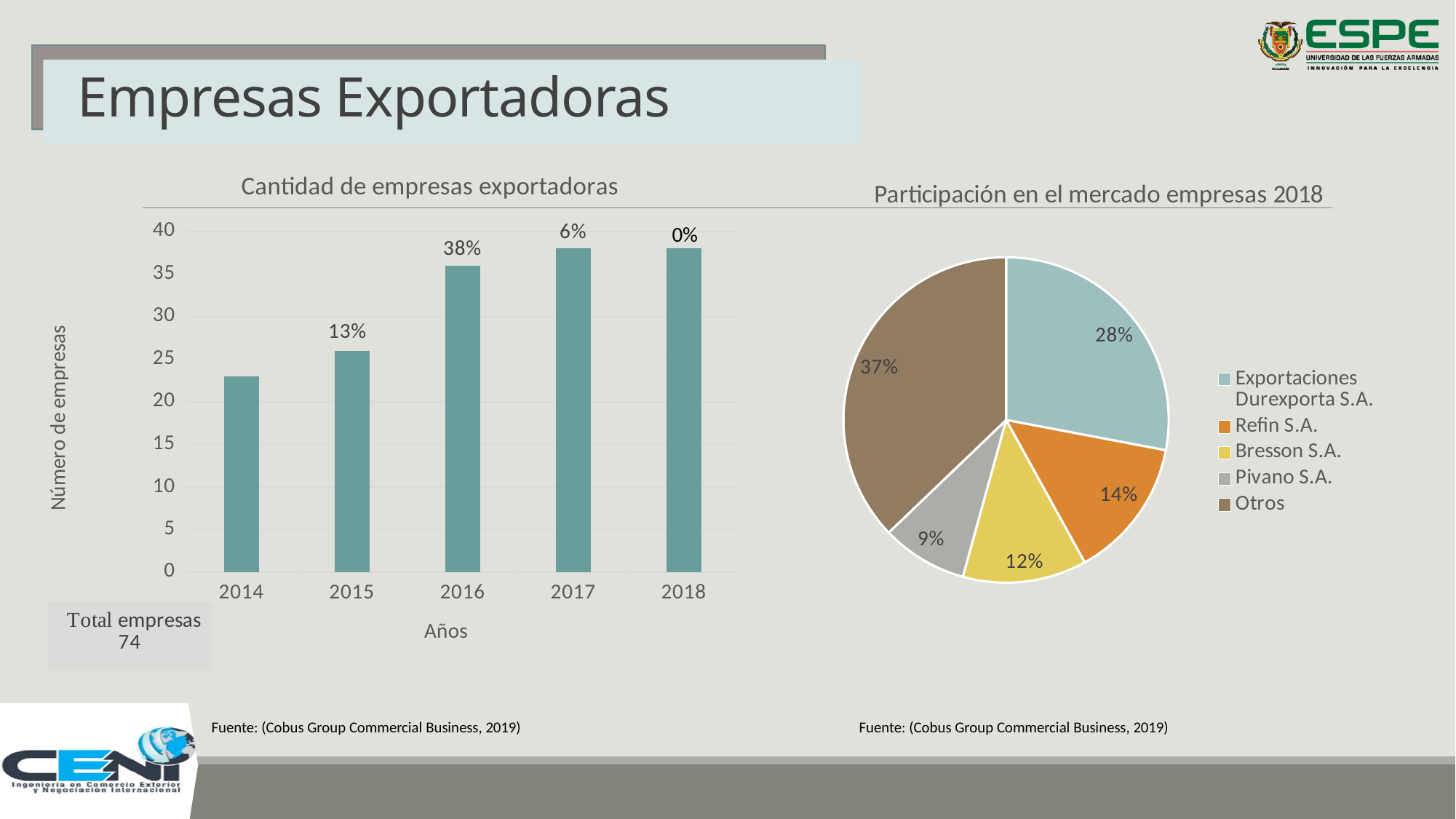
In the 'Cantidad de empresas exportadoras' chart, which year has the larger value, 2014 or 2016? 2016 What kind of chart is the 'Participación en el mercado empresas 2018' chart on the right? pie chart In the 'Participación en el mercado empresas 2018' pie chart, which slice is the largest? Otros In the 'Participación en el mercado empresas 2018' pie chart, which named company has the smallest share? Pivano S.A. What kind of chart is the 'Cantidad de empresas exportadoras' chart on the left? bar chart In the 'Participación en el mercado empresas 2018' pie chart, what share does Refin S.A. have? 14% In the 'Cantidad de empresas exportadoras' chart, do the values generally rise or fall from 2014 to 2018? rise In the 'Participación en el mercado empresas 2018' pie chart, how many percentage points larger is Exportaciones Durexporta S.A. than Bresson S.A.? 16 percentage points In the 'Participación en el mercado empresas 2018' pie chart, what share does Otros have? 37% In the 'Cantidad de empresas exportadoras' chart, is the value for 2017 greater or less than 35? greater In the 'Cantidad de empresas exportadoras' chart, is the value for 2014 greater or less than 25? less In the 'Cantidad de empresas exportadoras' chart, how many years are shown on the x axis? 5